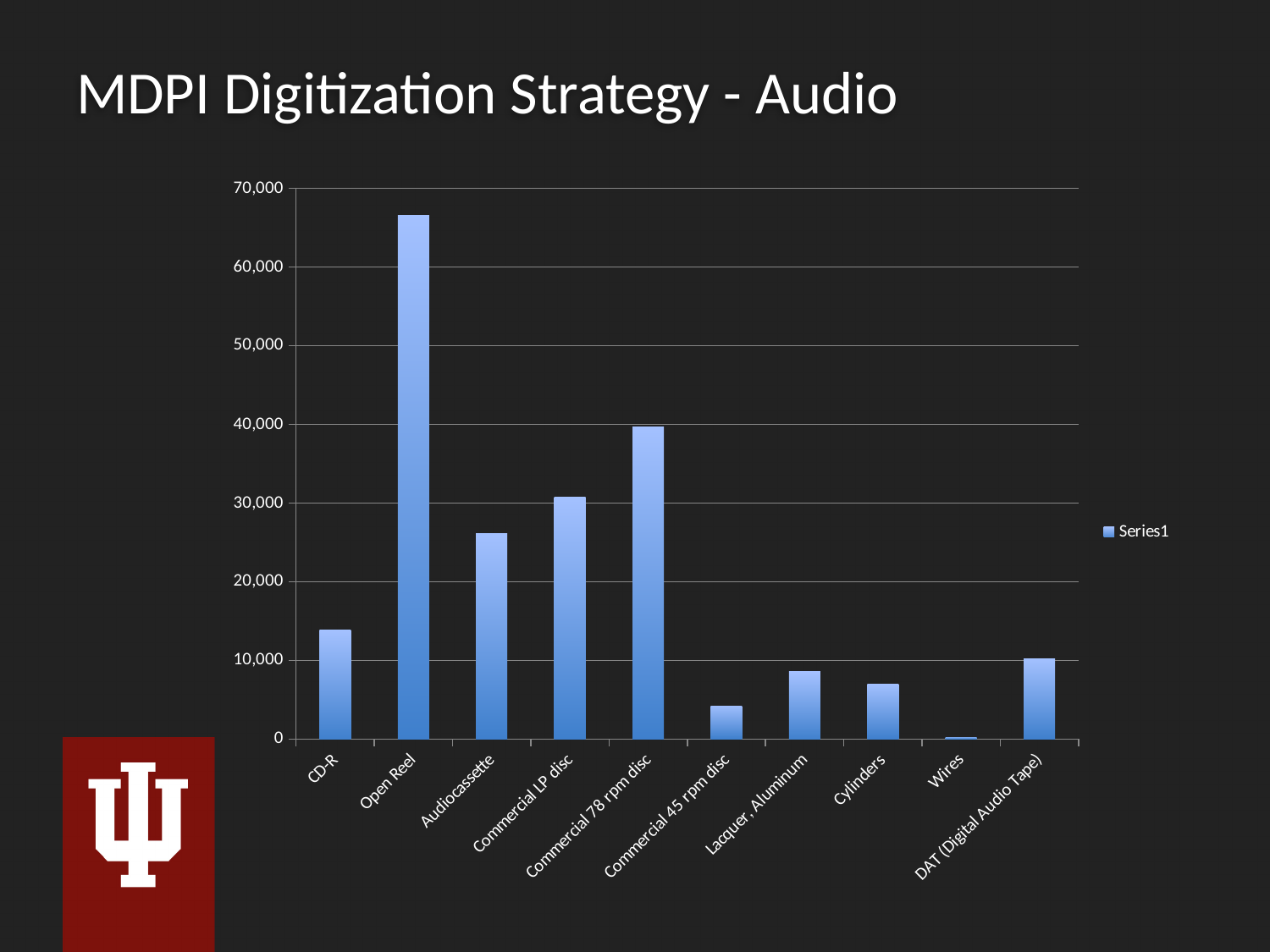
Is the value for Audiocassette greater or less than 20,000? greater Which category has the highest value in the chart? Open Reel Is the value for CD-R greater or less than 10,000? greater Which is larger, the value for Lacquer, Aluminum or the value for Cylinders? Lacquer, Aluminum Which category has the lowest value in the chart? Wires What kind of chart is shown on the slide? bar chart What is the name of the series shown in the chart legend? Series1 Is the value for Open Reel greater or less than 60,000? greater How many categories are shown on the x axis of the chart? 10 How many series does the chart legend list? 1 Which is larger, the value for Commercial 78 rpm disc or the value for Commercial LP disc? Commercial 78 rpm disc